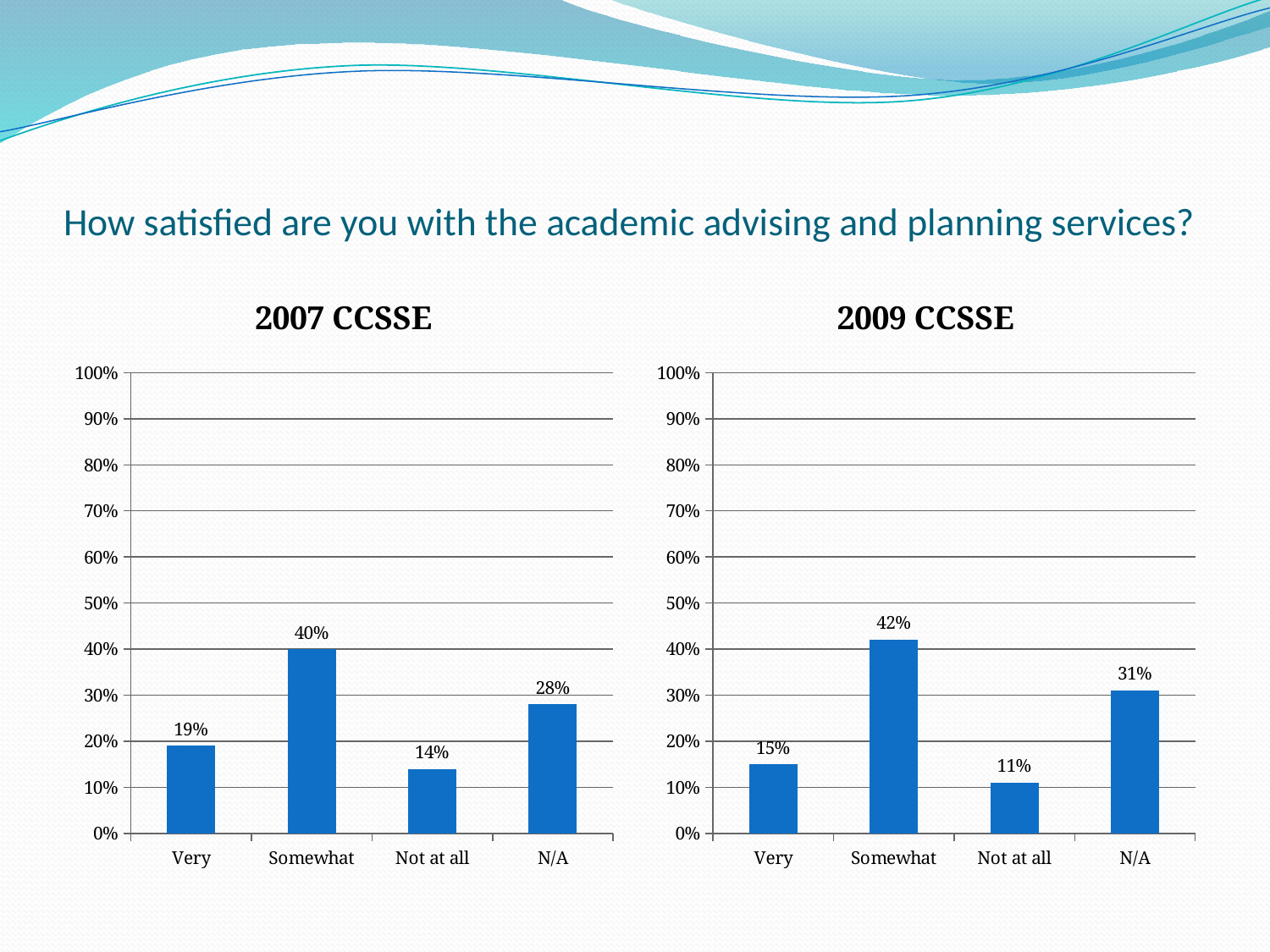
In the 2007 CCSSE chart, which category has the lowest value? Not at all How many categories are shown on the x axis of the 2007 CCSSE chart? 4 What kind of chart is the 2009 CCSSE chart? bar chart In the 2009 CCSSE chart, what is the value for Not at all? 11% What is the title of the chart on the left side of the slide? 2007 CCSSE In the 2009 CCSSE chart, which category has the highest value? Somewhat In the 2007 CCSSE chart, what is the difference between the N/A and Not at all values? 14% In the 2009 CCSSE chart, what is the difference between the Somewhat and Very values? 27% In the 2007 CCSSE chart, what is the value for Somewhat? 40% In the 2007 CCSSE chart, which is larger, the value for Very or the value for N/A? N/A In the 2009 CCSSE chart, what is the value for N/A? 31% In the 2009 CCSSE chart, is the value for Somewhat greater or less than 50%? less